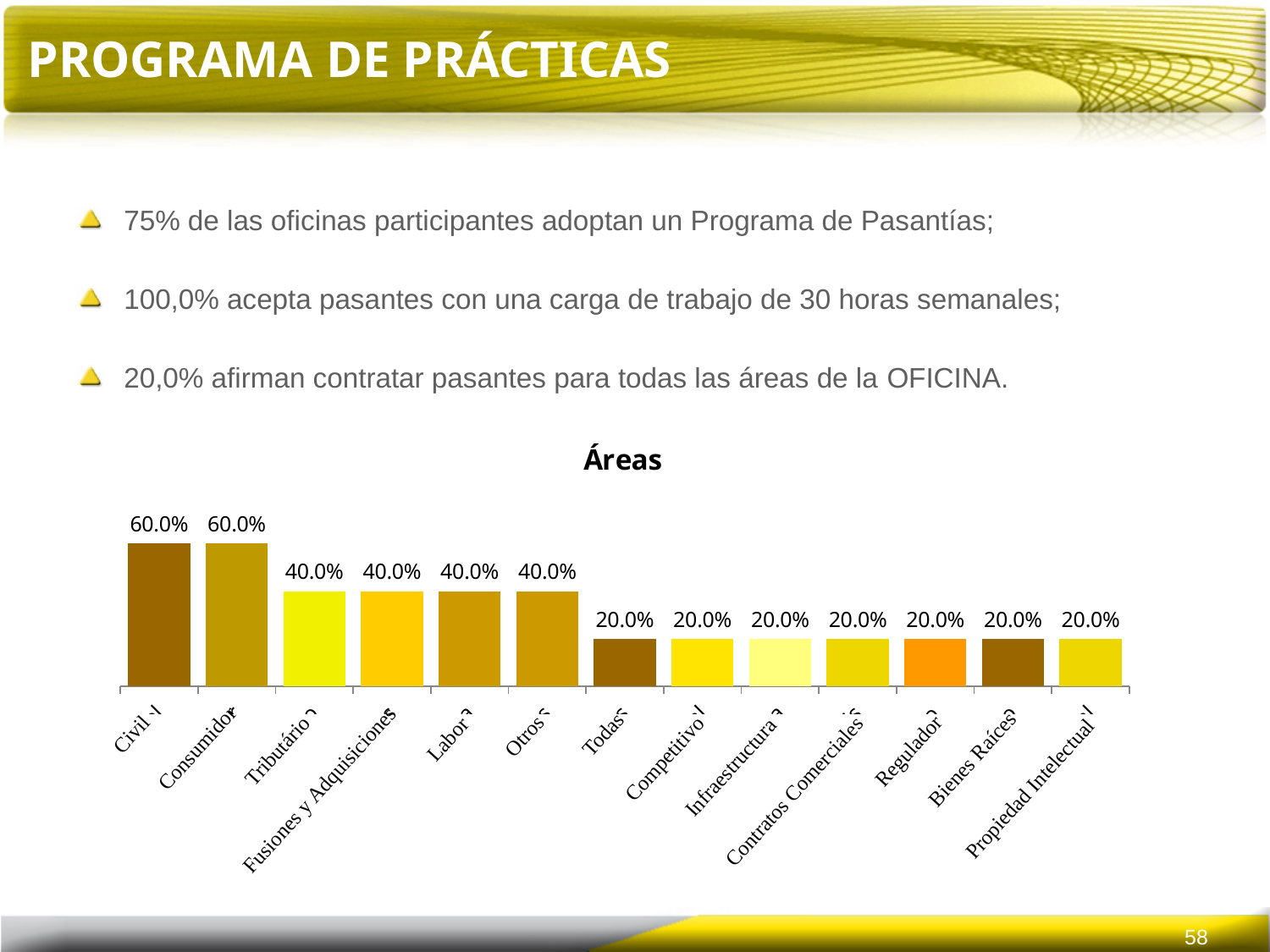
What is the value for Labor in the Áreas chart? 40.0% What is the value for Fusiones y Adquisiciones in the Áreas chart? 40.0% What kind of chart is shown under the title "Áreas"? bar chart How many categories are plotted in the Áreas chart? 13 What is the highest value shown in the Áreas chart? 60.0% What is the value for Propiedad Intelectual in the Áreas chart? 20.0% What is the title of the chart on the slide? Áreas What is the value for Civil in the Áreas chart? 60.0% Which has a larger value in the Áreas chart, Labor or Regulador? Labor What is the lowest value shown in the Áreas chart? 20.0% What is the difference between the values for Civil and Todas in the Áreas chart? 40.0% Do the values in the Áreas chart rise or fall from left to right? fall